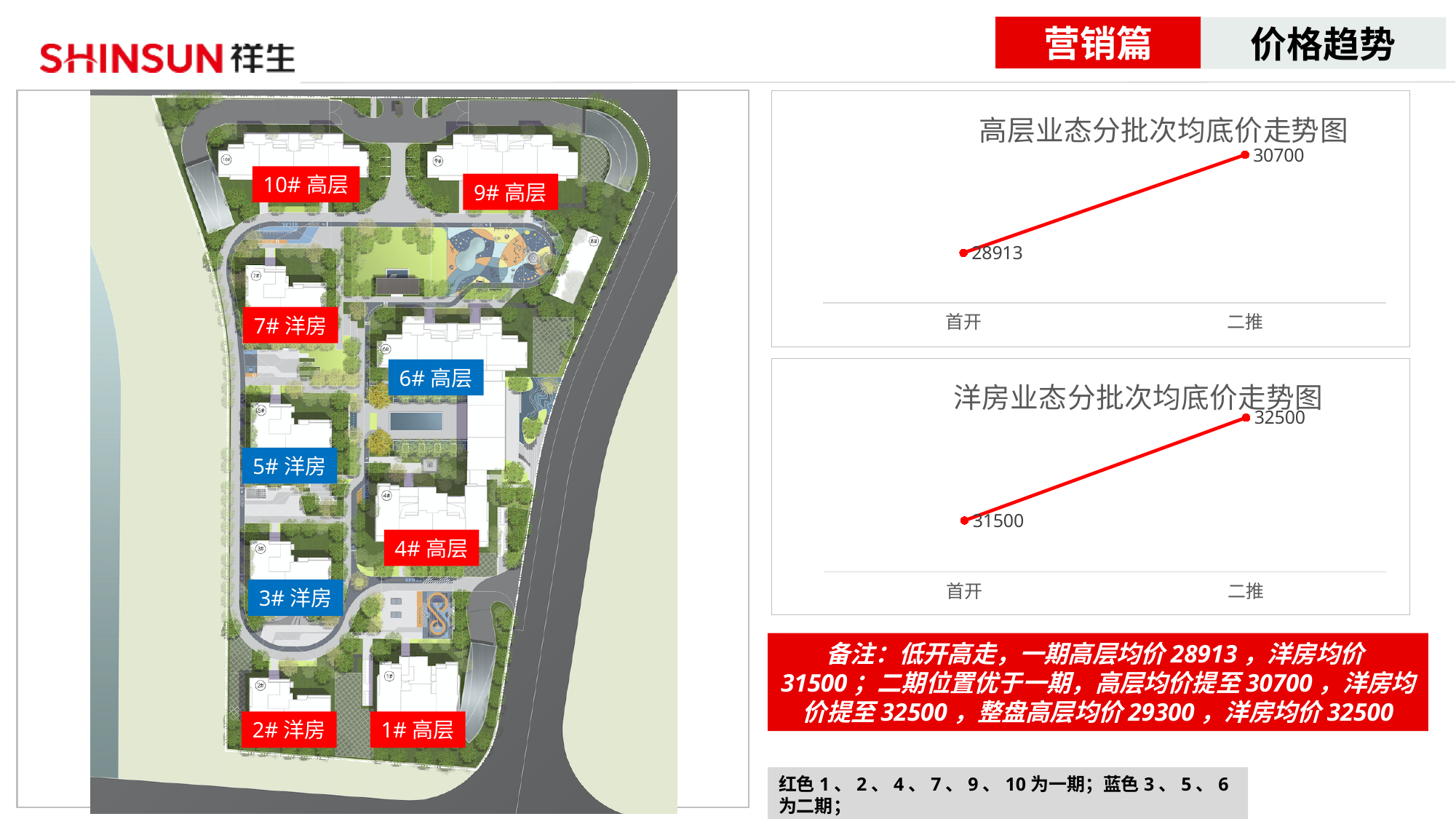
In the chart titled 洋房业态分批次均底价走势图, which point has the lowest value? 首开 In the chart titled 高层业态分批次均底价走势图, what is the value for 首开? 28913 In the chart titled 高层业态分批次均底价走势图, do the values rise or fall from 首开 to 二推? rise In the chart titled 洋房业态分批次均底价走势图, what is the difference between the 二推 value and the 首开 value? 1000 In the chart titled 洋房业态分批次均底价走势图, what is the value for 二推? 32500 What is the title of the lower chart on the right side of the slide? 洋房业态分批次均底价走势图 What kind of chart is the chart titled 高层业态分批次均底价走势图? line chart In the chart titled 高层业态分批次均底价走势图, which point is higher, 首开 or 二推? 二推 In the chart titled 高层业态分批次均底价走势图, what is the value for 二推? 30700 In the chart titled 洋房业态分批次均底价走势图, what is the value for 首开? 31500 In the chart titled 高层业态分批次均底价走势图, what is the difference between the 二推 value and the 首开 value? 1787 How many data points are plotted in the chart titled 洋房业态分批次均底价走势图? 2